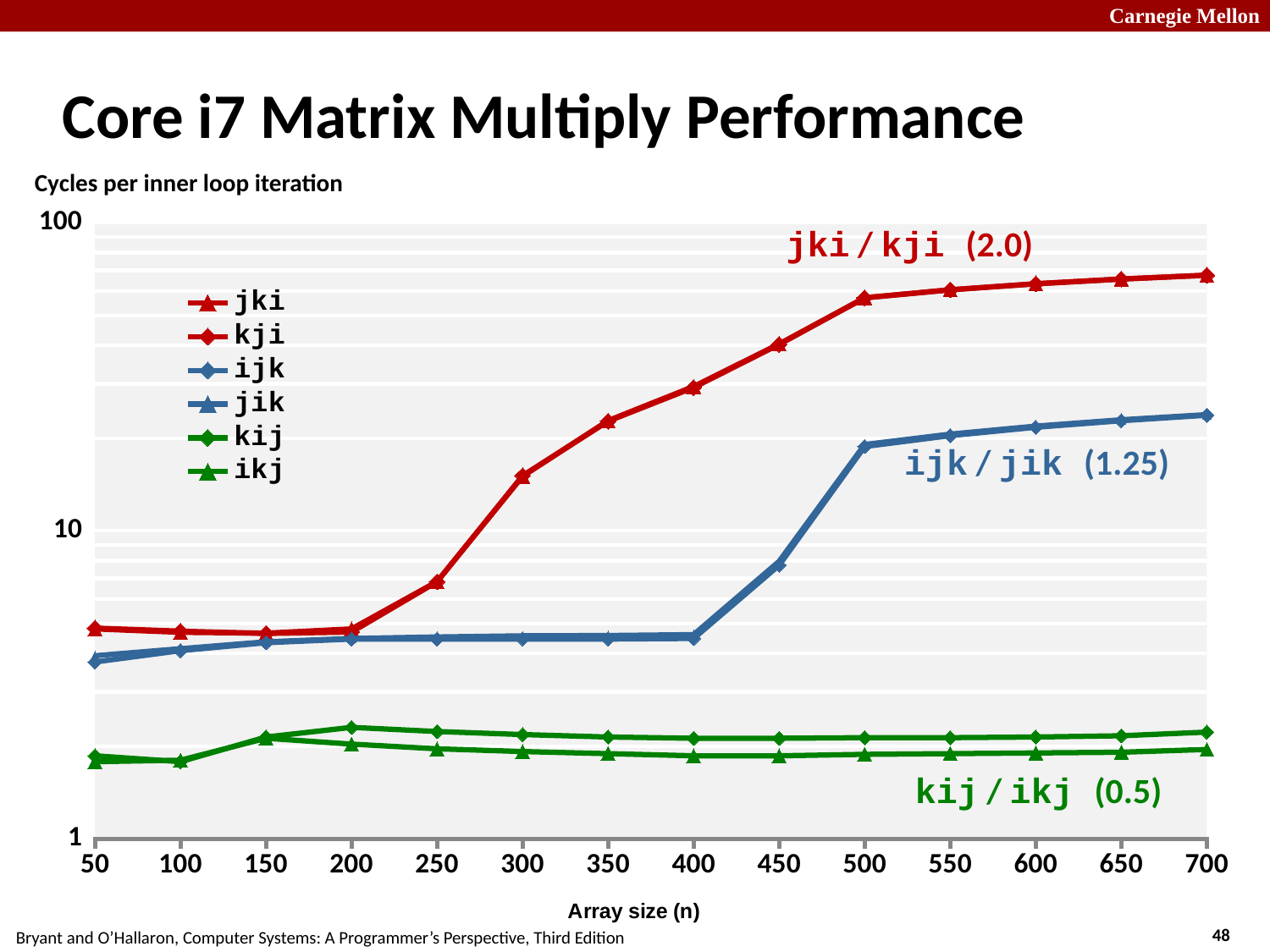
Which is larger at array size 700, the value for jki or the value for ijk? jki Is the value for jki at array size 700 greater or less than 10? greater What is the title of the chart? Core i7 Matrix Multiply Performance Is the value for ijk at array size 300 greater or less than 10? less Is the value for kij at array size 700 greater or less than 10? less Do the values for jki rise or fall as the array size increases from 200 to 700? rise What kind of chart is shown on the slide? line chart How many series does the legend list? 6 What is the label of the x axis? Array size (n) How many array size values are marked along the x axis? 14